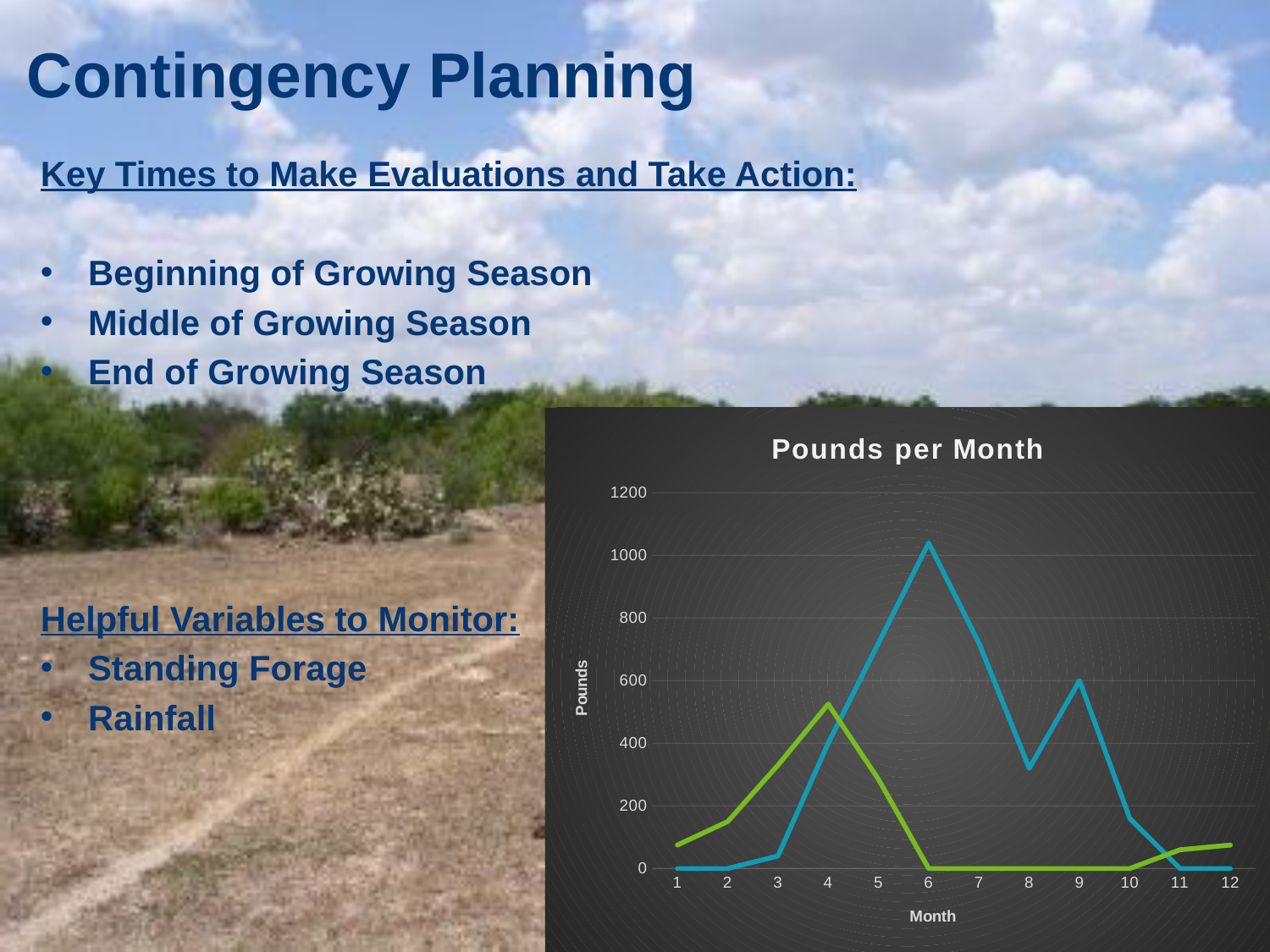
Does the blue line rise or fall between month 6 and month 8? fall Is the value of the green line at month 4 greater or less than 400? greater What is the title of the chart? Pounds per Month What is the label on the vertical axis of the chart? Pounds How many months are shown along the x axis of the chart? 12 In which month does the blue line reach its highest value? 6 What kind of chart is shown on the slide? line chart In which month does the green line reach its highest value? 4 Is the value of the blue line at month 6 greater or less than 800? greater Is the value of the blue line at month 8 greater or less than 200? greater At month 3, which line has the higher value, the green line or the blue line? green line